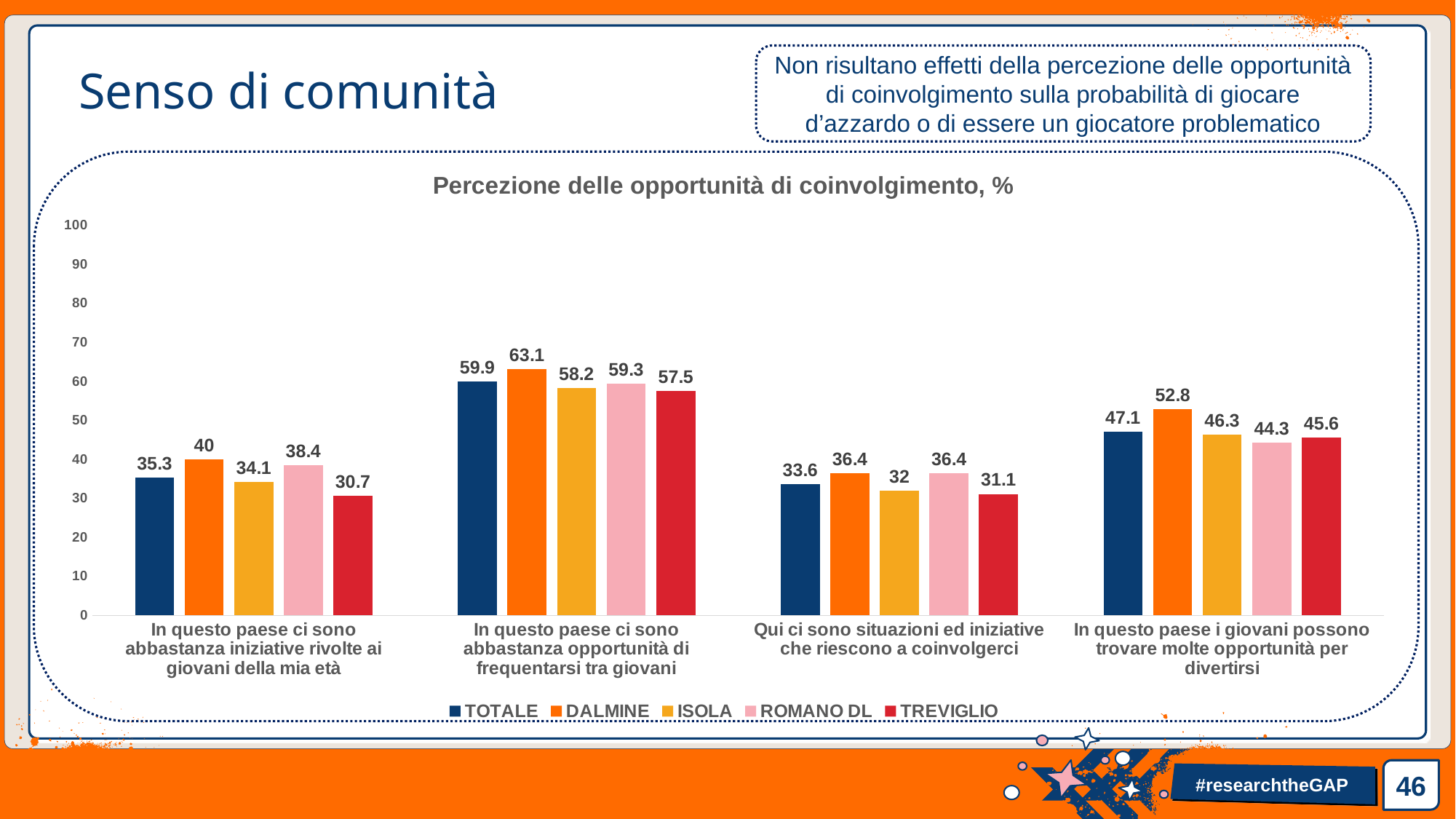
How many categories are shown on the x axis of the chart? 4 What is the TOTALE value for 'In questo paese i giovani possono trovare molte opportunità per divertirsi'? 47.1 How many series does the legend list? 5 Which series has the lowest value in the category 'In questo paese ci sono abbastanza iniziative rivolte ai giovani della mia età'? TREVIGLIO What is the value for ISOLA in the category 'Qui ci sono situazioni ed iniziative che riescono a coinvolgerci'? 32 Is the TOTALE value for 'In questo paese ci sono abbastanza opportunità di frequentarsi tra giovani' greater or less than 50? greater What is the difference between the DALMINE and TREVIGLIO values in the category 'In questo paese ci sono abbastanza opportunità di frequentarsi tra giovani'? 5.6 What kind of chart is shown on the slide? Bar chart Which is larger: the ROMANO DL value for 'In questo paese ci sono abbastanza iniziative rivolte ai giovani della mia età' or the ROMANO DL value for 'Qui ci sono situazioni ed iniziative che riescono a coinvolgerci'? In questo paese ci sono abbastanza iniziative rivolte ai giovani della mia età What is the value for TREVIGLIO in the category 'In questo paese ci sono abbastanza iniziative rivolte ai giovani della mia età'? 30.7 What is the value for DALMINE in the category 'In questo paese ci sono abbastanza opportunità di frequentarsi tra giovani'? 63.1 Which series has the highest value in the category 'In questo paese i giovani possono trovare molte opportunità per divertirsi'? DALMINE